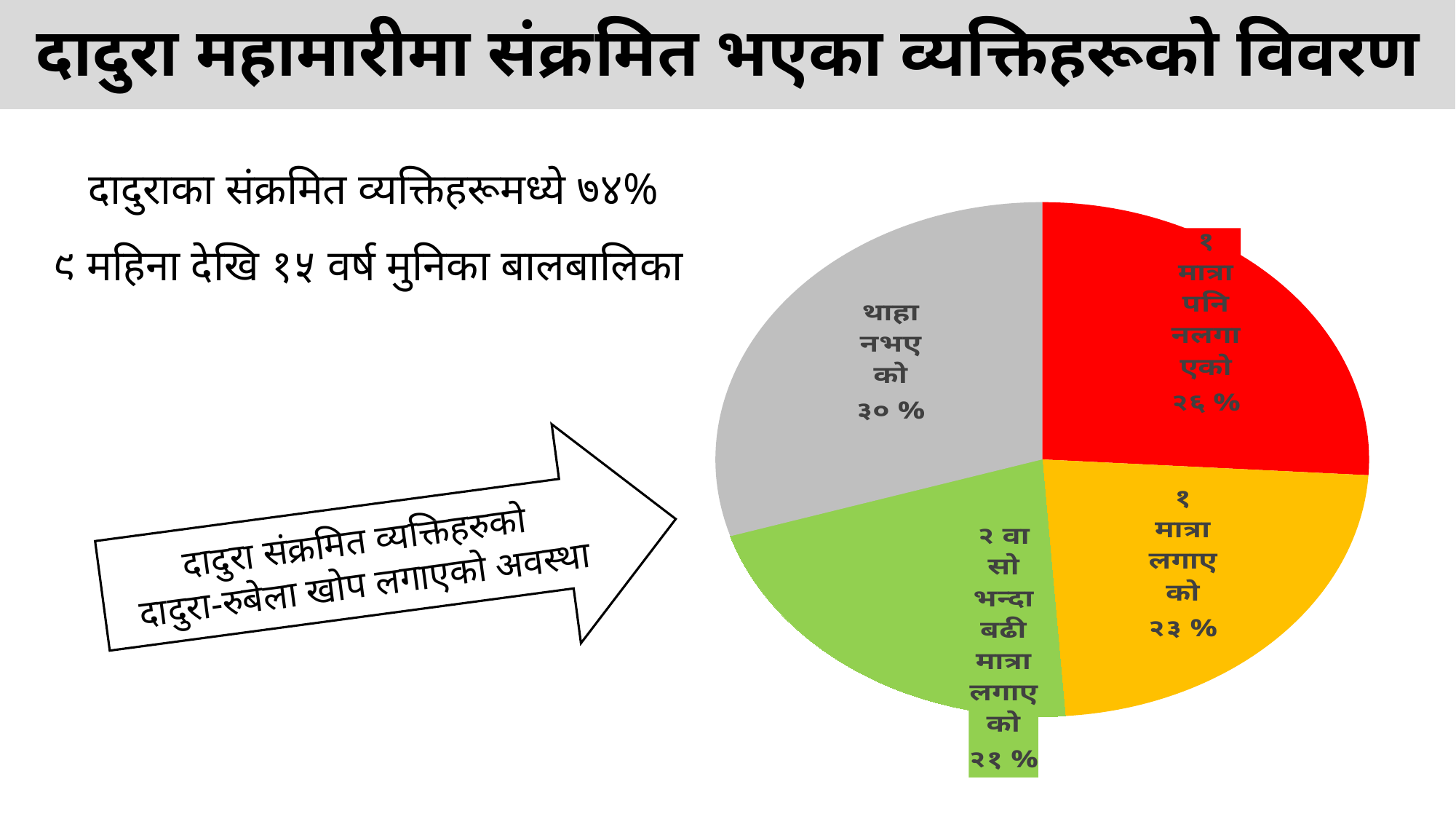
What is the value shown for the slice labelled 'थाहा नभएको'? ३० % What is the value shown for the slice labelled '२ वा सो भन्दा बढी मात्रा लगाएको'? २१ % What is the value shown for the slice labelled '१ मात्रा लगाएको'? २३ % What kind of chart is shown on the slide? pie chart Which slice of the pie chart is the smallest? २ वा सो भन्दा बढी मात्रा लगाएको What colour is the slice labelled 'थाहा नभएको'? grey Which slice of the pie chart is the largest? थाहा नभएको What is the value shown for the slice labelled '१ मात्रा पनि नलगाएको'? २६ % How many slices does the pie chart have? 4 What is the difference between the 'थाहा नभएको' slice and the '२ वा सो भन्दा बढी मात्रा लगाएको' slice? ९ % Which is larger: the slice for '१ मात्रा पनि नलगाएको' or the slice for '२ वा सो भन्दा बढी मात्रा लगाएको'? १ मात्रा पनि नलगाएको What colour is the slice labelled '१ मात्रा लगाएको'? yellow